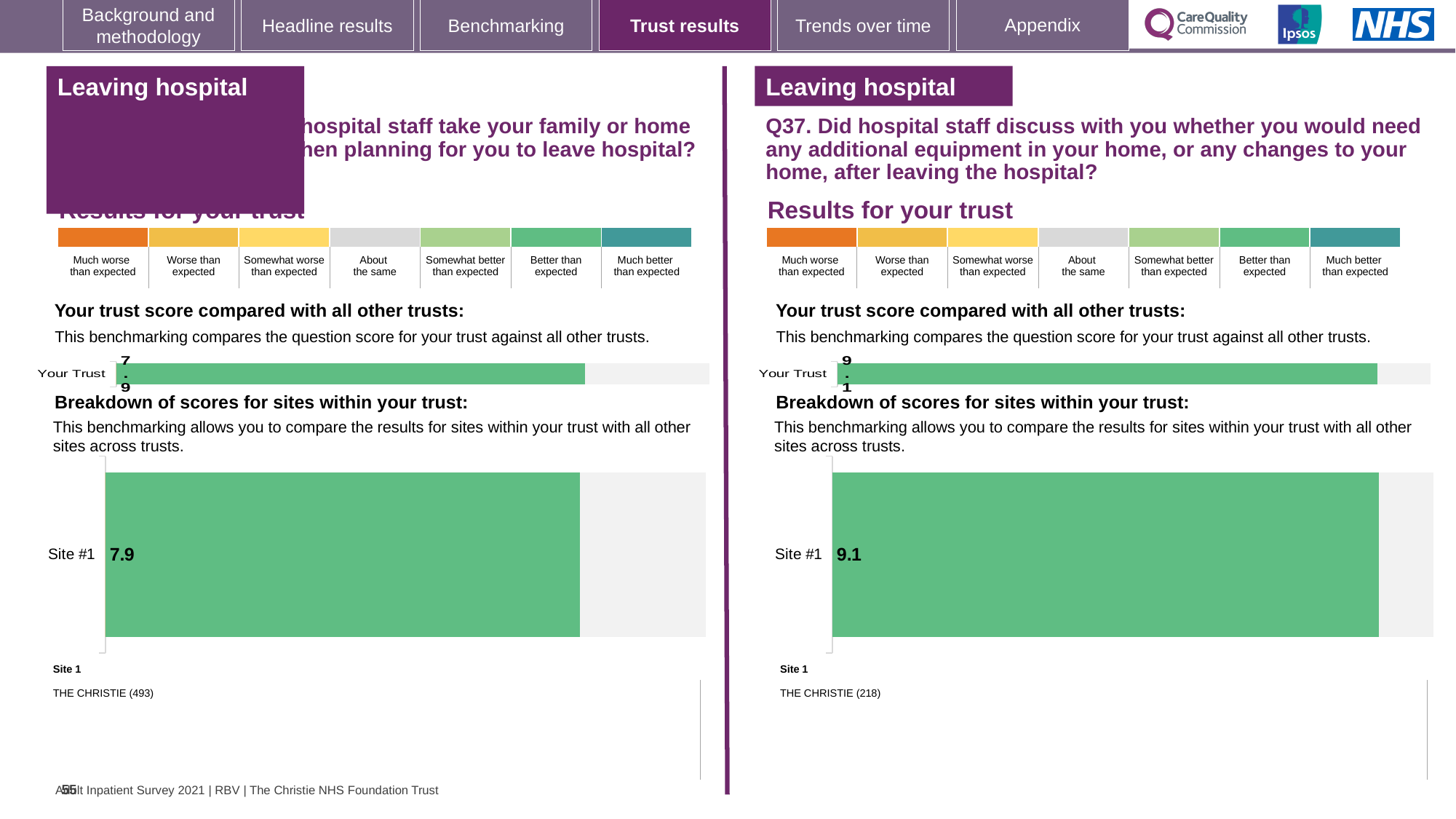
What is the difference between the Site #1 score on the right half of the slide (Q37) and the Site #1 score on the left half? 1.2 Which Site #1 score is larger: the one on the left half of the slide or the one on the right half (Q37)? The right half (Q37), 9.1 What type of chart is used to show the Site #1 score on the right half of the slide (Q37)? Bar chart What is the name of Site 1 listed below the breakdown chart on the left half of the slide? THE CHRISTIE (493) How many sites are shown in the breakdown of scores chart on the right half of the slide (Q37)? 1 On the right half of the slide (Q37), what is the 'Your Trust' score in the trust score comparison chart? 9.1 On the left half of the slide, what is the score shown for Site #1 in the breakdown of scores for sites within your trust? 7.9 How many sites are shown in the breakdown of scores chart on the left half of the slide? 1 On the right half of the slide (Q37), is the Site #1 score greater or less than 8? greater On the right half of the slide (Q37), what is the score shown for Site #1 in the breakdown of scores for sites within your trust? 9.1 What is the name of Site 1 listed below the breakdown chart on the right half of the slide (Q37)? THE CHRISTIE (218) On the left half of the slide, what is the 'Your Trust' score in the trust score comparison chart? 7.9